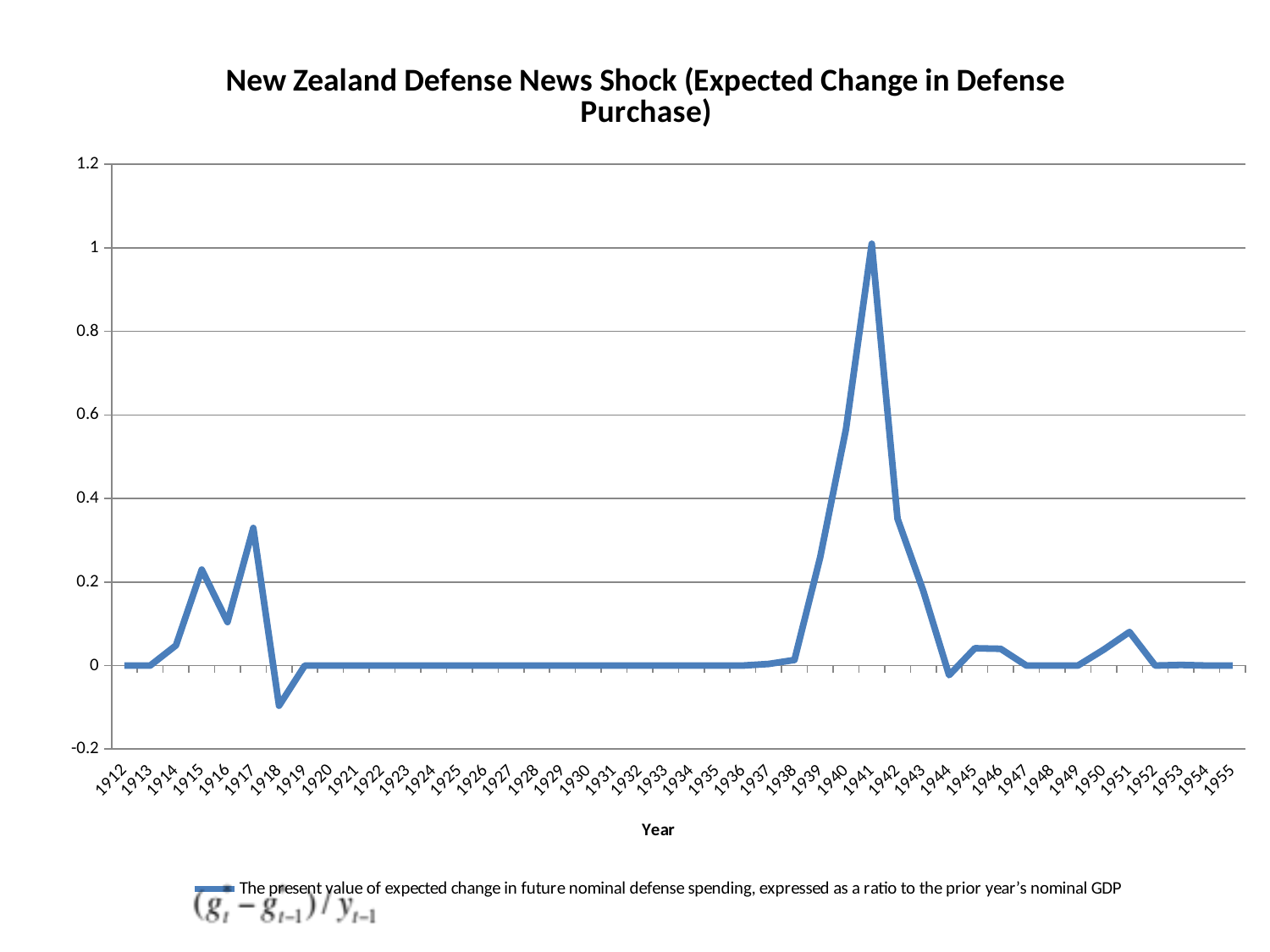
Which is larger, the value for 1940 or the value for 1942? 1940 Is the value for 1941 greater or less than 0.8? greater Which year has the lowest value? 1918 Do the values rise or fall from 1938 to 1941? rise Is the value for 1918 greater or less than 0? less Is the value for 1942 greater or less than 0.4? less How many series does the legend list? 1 What is the title of the x axis? Year How many years are plotted along the x axis? 44 Which year has the highest value? 1941 What kind of chart is shown on the slide? line chart